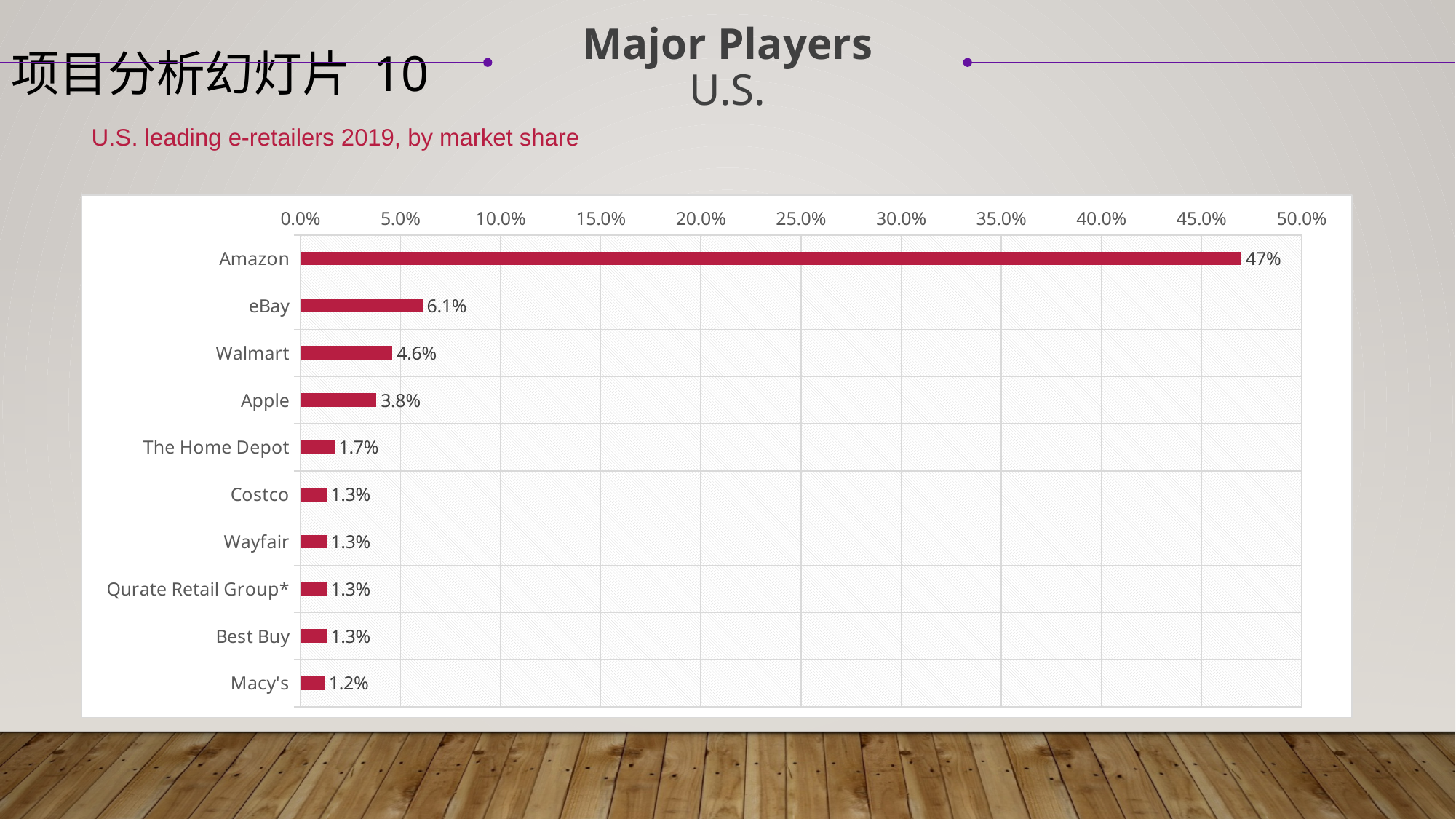
What is the market share shown for eBay? 6.1% What is the market share shown for Amazon? 47% What is the difference in market share between eBay and Walmart? 1.5% What kind of chart is shown on the slide? Bar chart How many e-retailers are listed in the chart? 10 What is the market share shown for The Home Depot? 1.7% What is the title of the chart on the slide? U.S. leading e-retailers 2019, by market share Which has a larger market share, Apple or Walmart? Walmart Which e-retailer has the lowest market share in the chart? Macy's What is the market share shown for Walmart? 4.6% Which e-retailer has the highest market share in the chart? Amazon What is the market share shown for Macy's? 1.2%